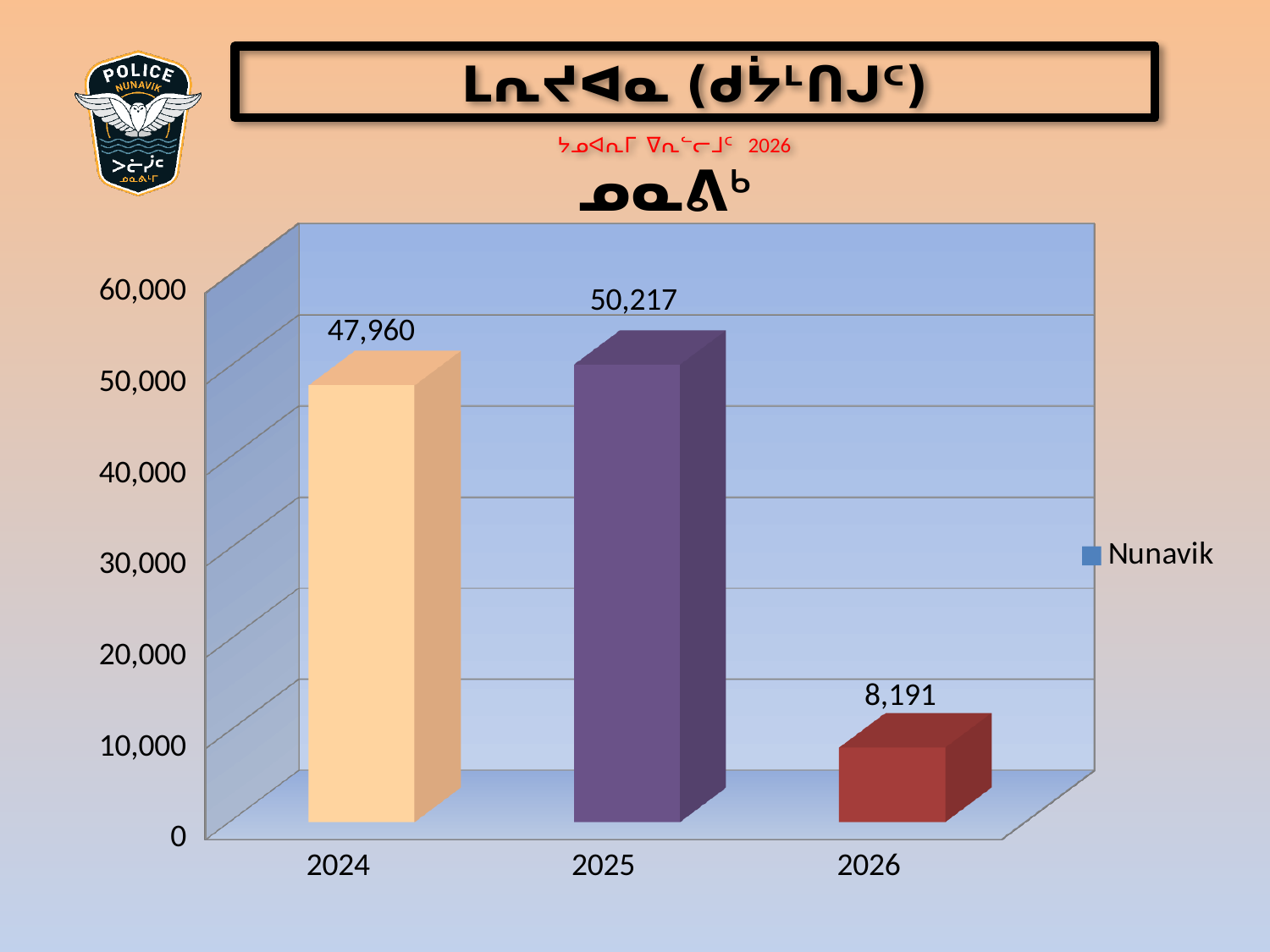
What is the difference between the values for 2025 and 2024? 2,257 How many series does the legend list? 1 Which is larger, the value for 2024 or the value for 2026? 2024 What is the value for 2024? 47,960 Which year has the highest value? 2025 Is the value for 2026 greater or less than 10,000? less What kind of chart is shown on the slide? bar chart How many years are shown on the x axis? 3 What is the value for 2026? 8,191 What is the value for 2025? 50,217 What is the difference between the values for 2024 and 2026? 39,769 Which year has the lowest value? 2026